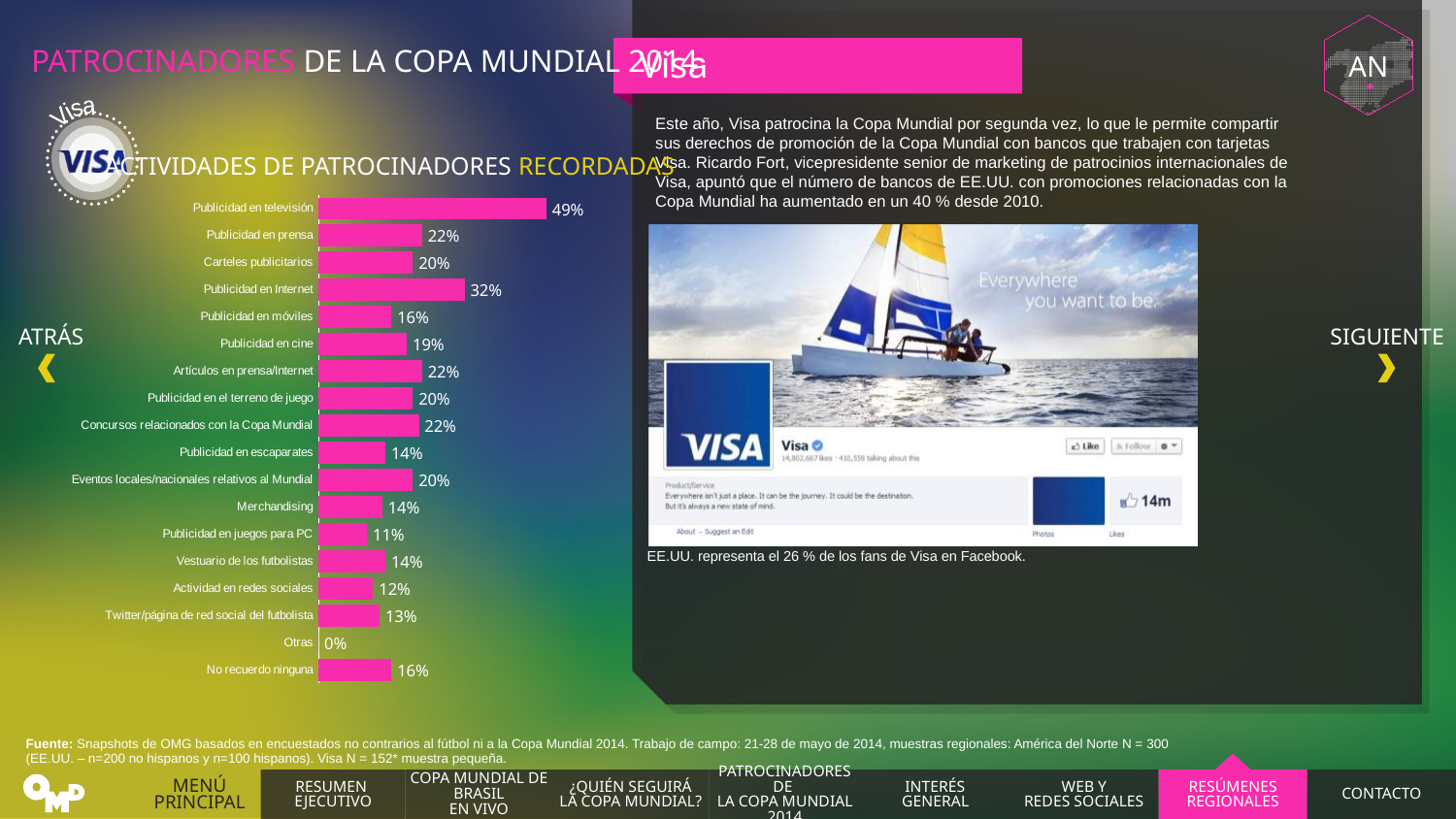
Which is larger, Publicidad en cine or Publicidad en móviles? Publicidad en cine What is the value for Publicidad en televisión? 49% What is the value for Publicidad en juegos para PC? 11% What is the difference between Publicidad en prensa and Actividad en redes sociales? 10% Which category has the lowest value? Otras What is the value for Publicidad en Internet? 32% What type of chart is shown on the slide? bar chart What is the title of the chart? ACTIVIDADES DE PATROCINADORES RECORDADAS What is the difference between Publicidad en televisión and Publicidad en Internet? 17% How many categories are shown in the chart? 18 Which category has the highest value? Publicidad en televisión What is the value for No recuerdo ninguna? 16%